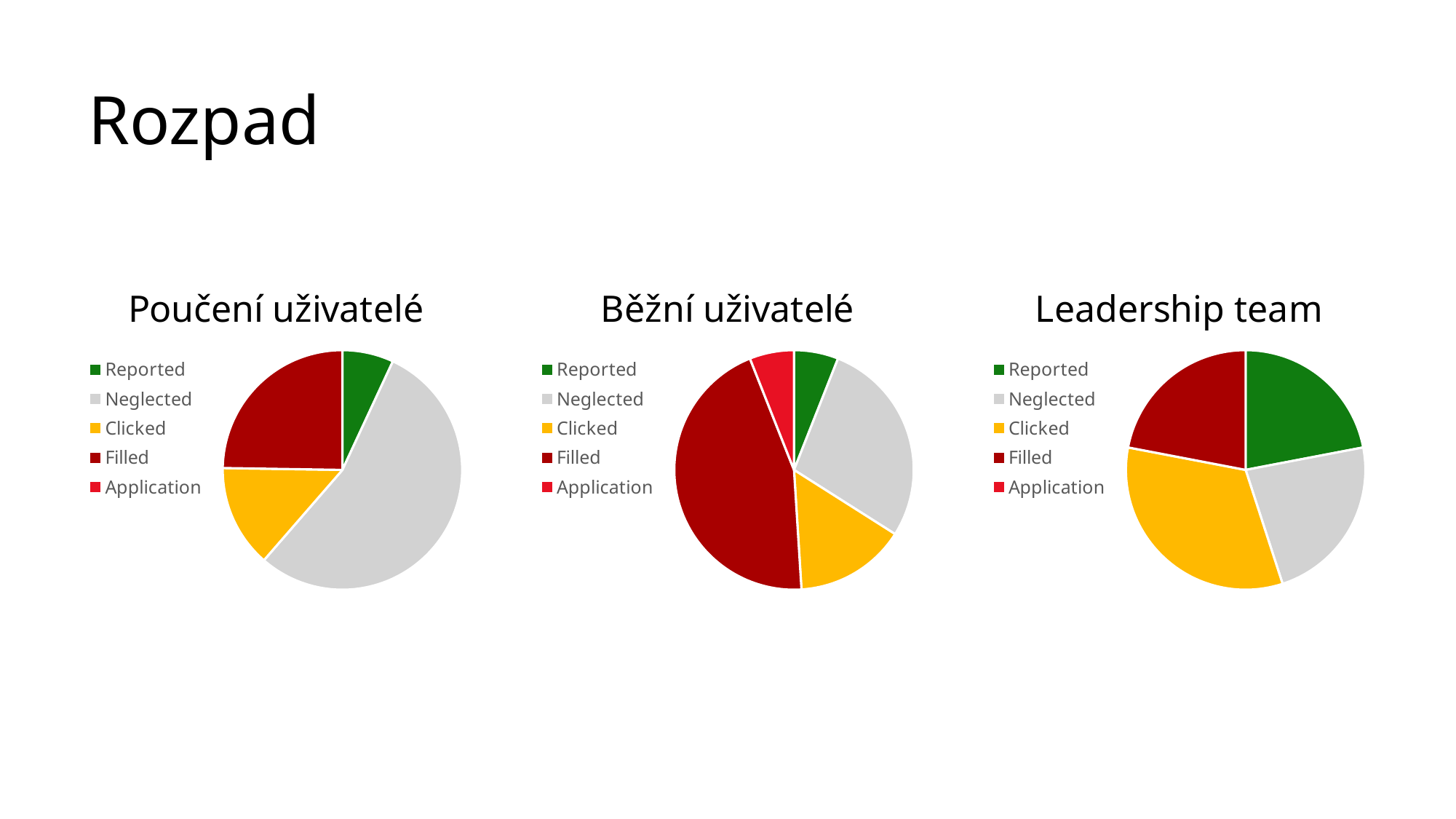
What kind of chart is "Poučení uživatelé"? pie chart What colour represents the Clicked category in the charts? yellow In the "Běžní uživatelé" chart, which category has the largest slice? Filled In the "Běžní uživatelé" chart, which slice is larger, Neglected or Clicked? Neglected In the "Poučení uživatelé" chart, which category has the largest slice? Neglected How many pie charts are shown on the slide? 3 How many entries does the legend of the "Leadership team" chart list? 5 In the "Poučení uživatelé" chart, which visible slice is the smallest? Reported In the "Poučení uživatelé" chart, which slice is larger, Filled or Clicked? Filled In the "Leadership team" chart, which category has the largest slice? Clicked In the "Běžní uživatelé" chart, which slice is larger, Filled or Neglected? Filled